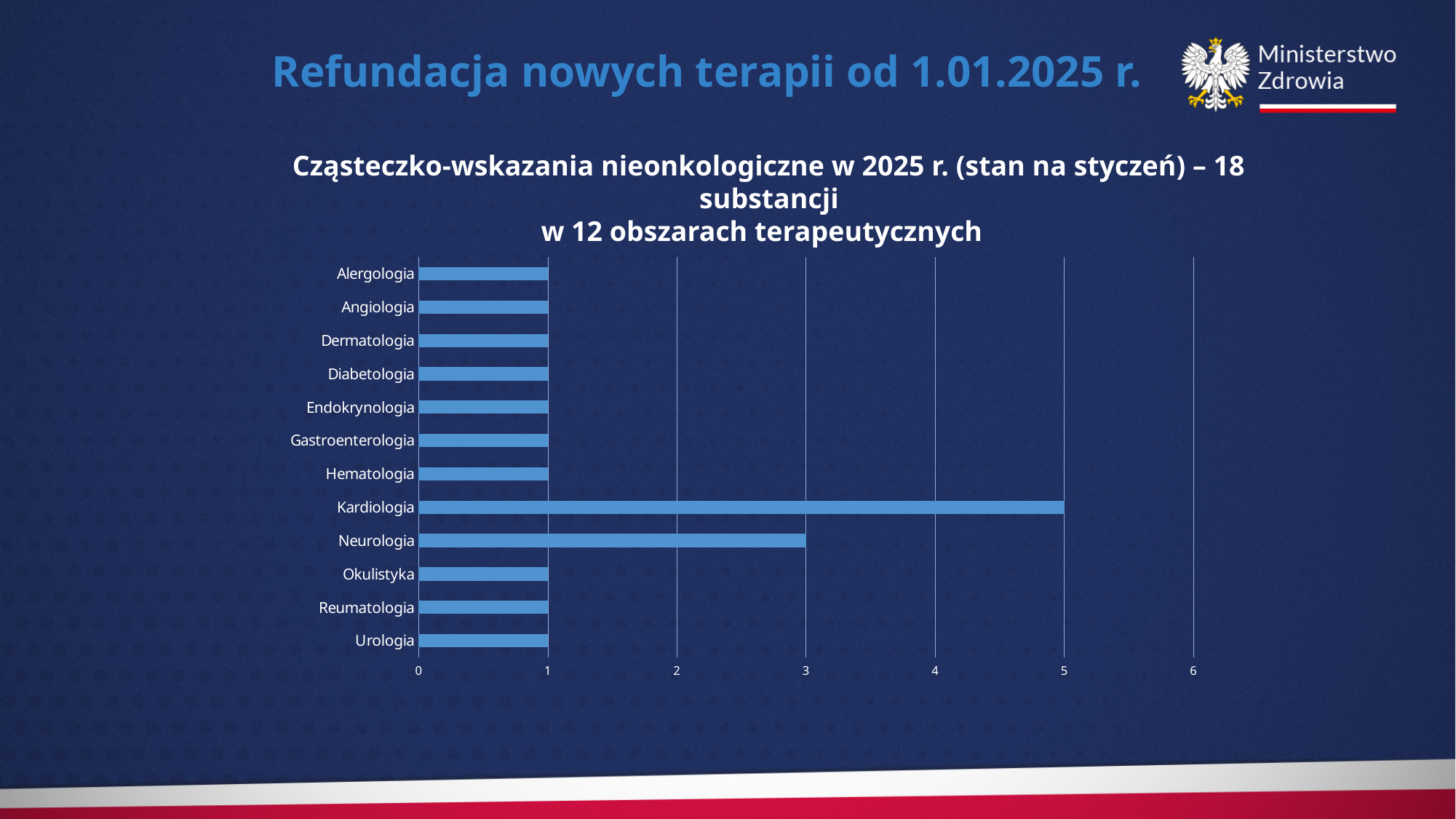
What is the highest value shown on the horizontal axis of the chart? 6 How many therapeutic areas (categories) are plotted on the chart? 12 Is the value for Urologia greater or less than 2? less What is the value for Alergologia? 1 What is the value for Neurologia? 3 According to the chart title, how many substances are covered? 18 Is the value for Kardiologia greater or less than 4? greater Which therapeutic area has the highest value on the chart? Kardiologia Which is larger, the value for Neurologia or the value for Hematologia? Neurologia What kind of chart is shown on the slide? bar chart What is the value for Kardiologia? 5 What is the difference between the values for Kardiologia and Neurologia? 2